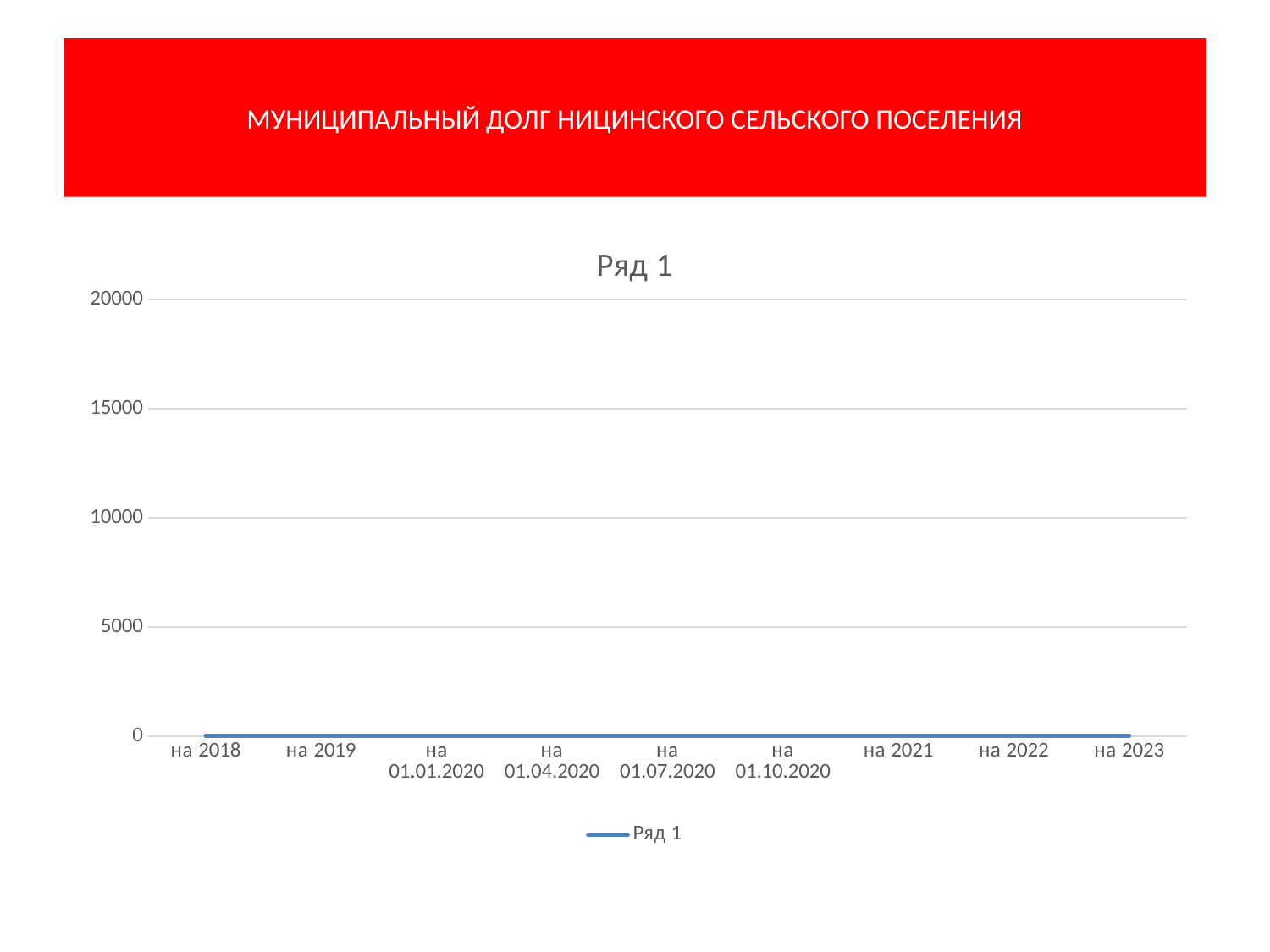
Do the values rise, fall, or stay flat from 'на 2018' to 'на 2023'? stay flat What is the name of the series shown in the legend? Ряд 1 What is the value for 'на 2023'? 0 What is the value for 'на 2018'? 0 What is the difference between the values for 'на 2019' and 'на 2022'? 0 Is the value for 'на 01.07.2020' greater or less than 10000? less Is the value for 'на 2021' greater or less than 5000? less What is the highest value shown on the y axis? 20000 How many series does the legend list? 1 How many categories are shown along the x axis? 9 What is the chart title shown above the plot area? Ряд 1 What kind of chart is shown on the slide? line chart